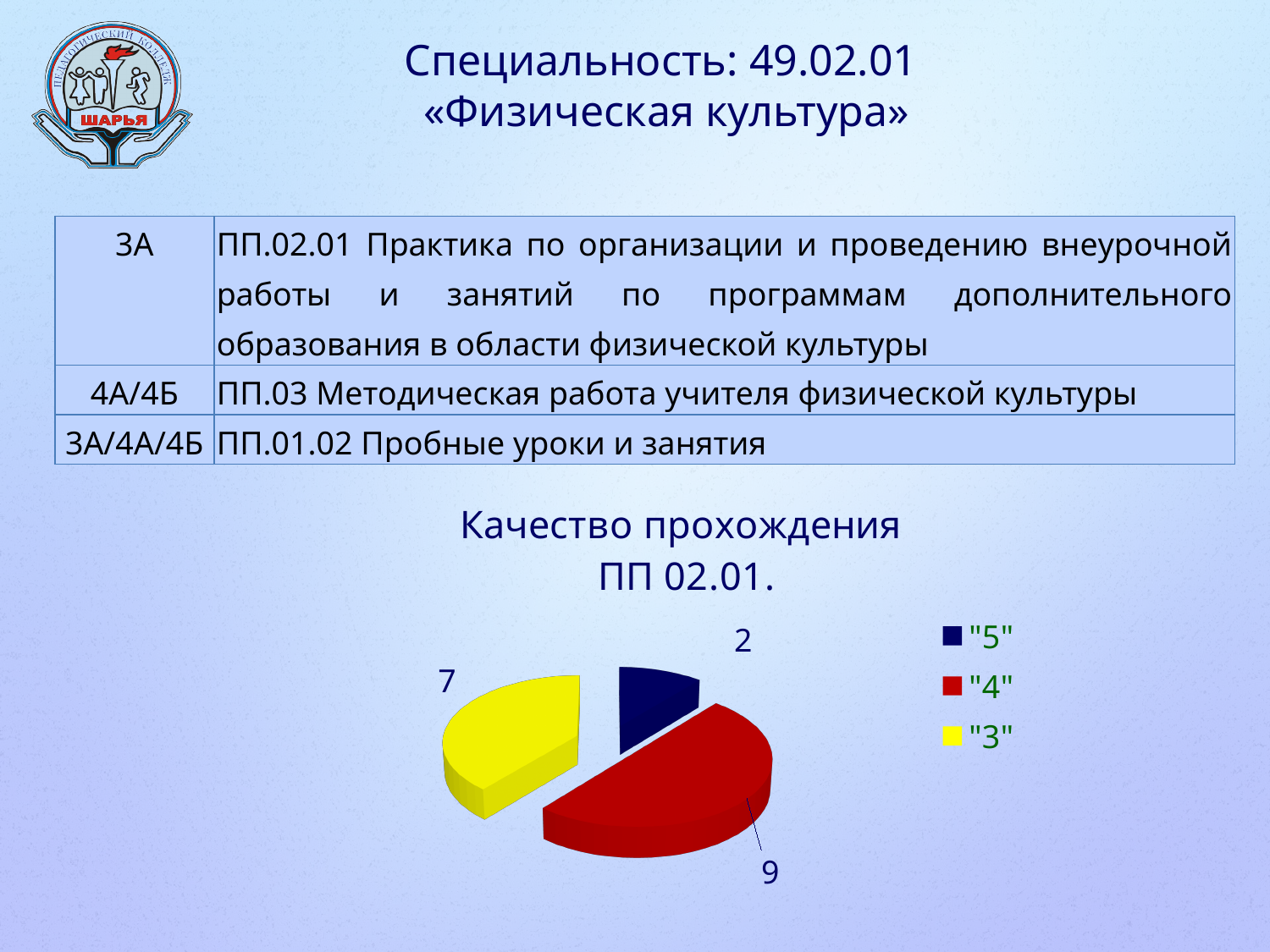
What share of the pie does the "4" slice represent? 50% What is the value for the "3" slice? 7 How many slices does the pie chart have? 3 Which grade has the largest slice of the pie? "4" What kind of chart is shown on the slide? pie chart Which grade has the smallest slice of the pie? "5" How many entries does the chart legend list? 3 What is the value for the "5" slice? 2 What is the value for the "4" slice? 9 What is the title of the chart? Качество прохождения ПП 02.01. What is the difference between the values for "4" and "3"? 2 Which is larger, the value for "3" or the value for "5"? "3"